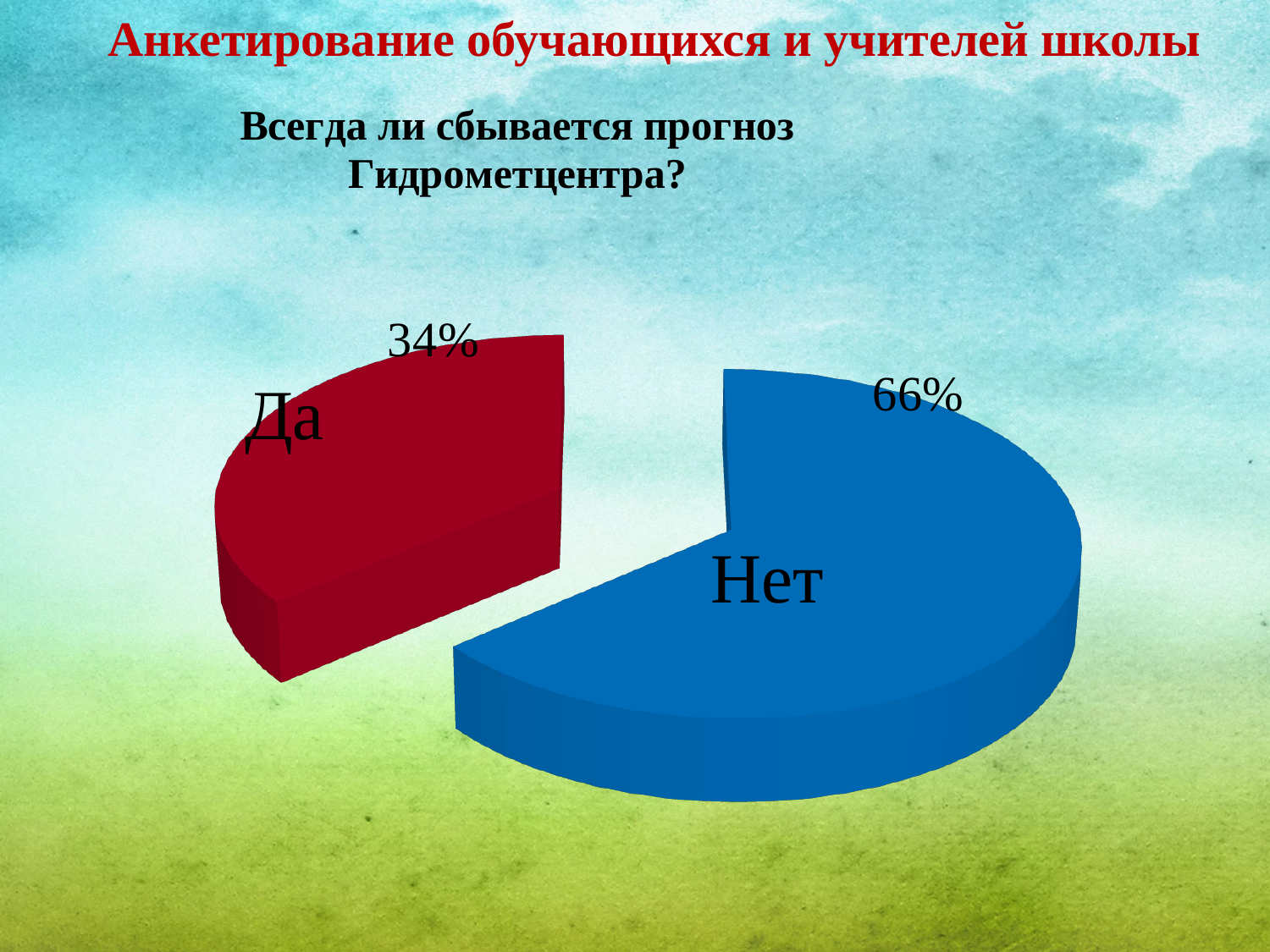
Is the share for "Да" greater or less than 50%? less What percentage of respondents answered "Нет"? 66% What question does the chart title ask? Всегда ли сбывается прогноз Гидрометцентра? What percentage of respondents answered "Да"? 34% What kind of chart is shown on the slide? pie chart Which answer has the largest share of the pie? Нет How many slices does the pie chart have? 2 Which answer has the smallest share of the pie? Да What is the difference in percentage points between the "Нет" and "Да" slices? 32 What share of the pie does the "Нет" slice represent? 66% What colour is the "Да" slice? red Which slice is larger, "Да" or "Нет"? Нет